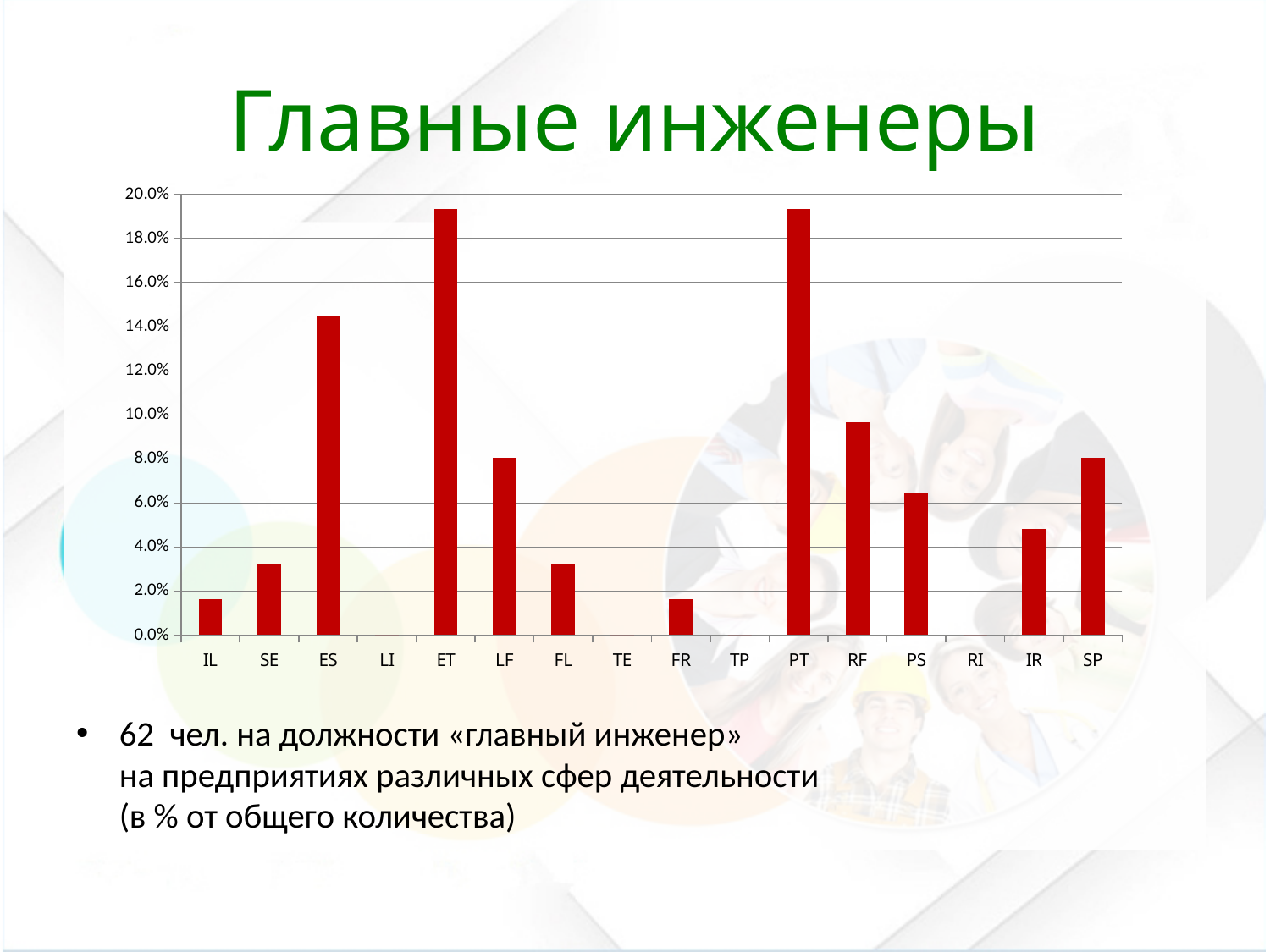
Which has the larger value, IR or LF? LF Is the value for PS greater or less than 8.0%? less Which has the larger value, ES or RF? ES Is the value for ES greater or less than 12.0%? greater Is the value for SE greater or less than 4.0%? less How many categories on the chart have no visible bar (a value of 0.0%)? 4 How many categories are shown on the x axis of the chart? 16 What is the title of the slide containing the chart? Главные инженеры What kind of chart is shown on the slide? bar chart